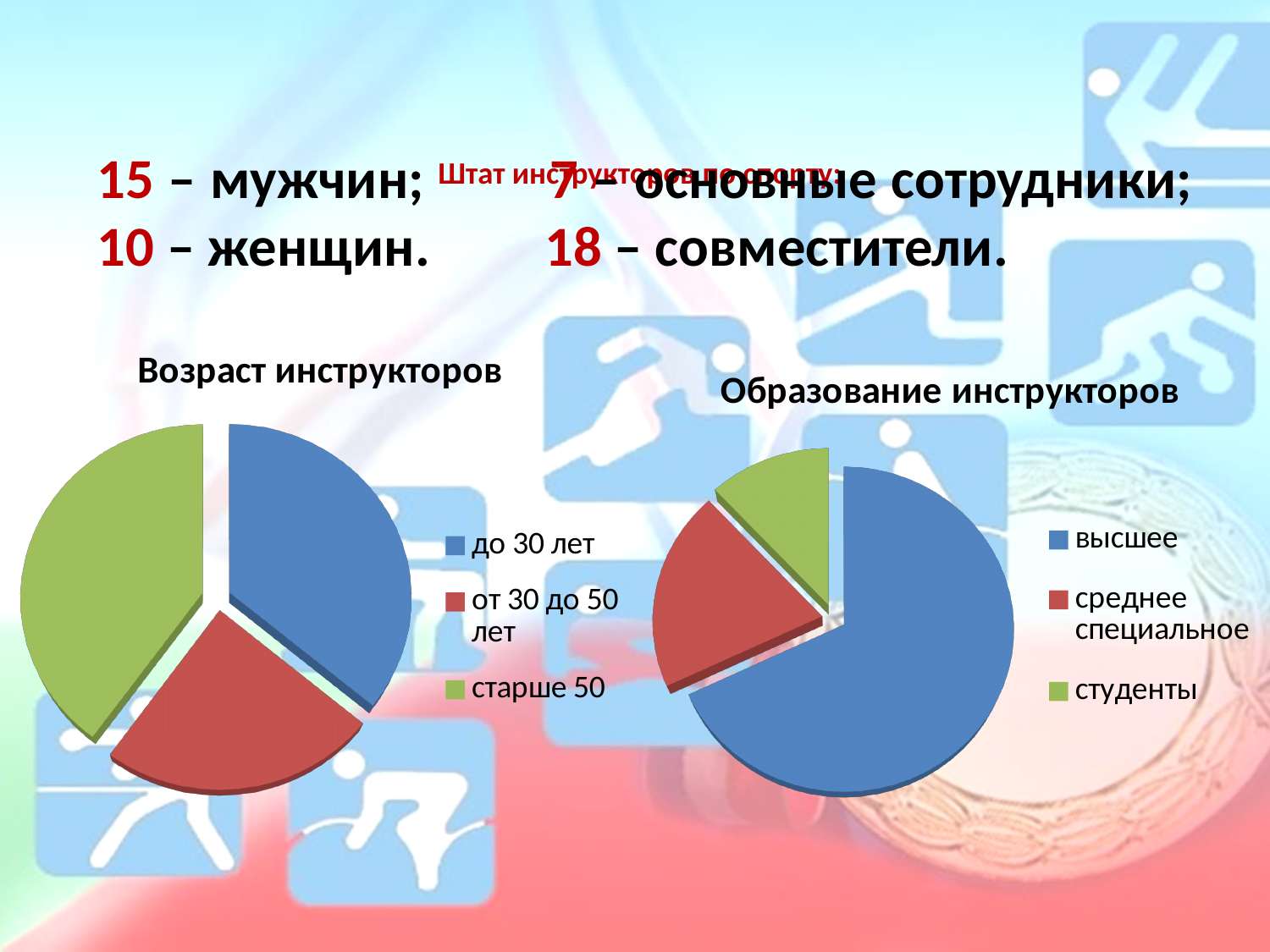
What kind of chart is the "Образование инструкторов" chart? pie chart What kind of chart is the "Возраст инструкторов" chart? pie chart In the "Возраст инструкторов" chart, what colour is the "старше 50" slice? green In the "Образование инструкторов" chart, how many categories does the legend list? 3 In the "Возраст инструкторов" chart, how many slices does the pie have? 3 In the "Образование инструкторов" chart, what colour is the "высшее" slice? blue In the "Образование инструкторов" chart, which category has the largest slice? высшее In the "Образование инструкторов" chart, which slice is larger: "среднее специальное" or "студенты"? среднее специальное In the "Образование инструкторов" chart, which slice is larger: "высшее" or "среднее специальное"? высшее In the "Образование инструкторов" chart, which category has the smallest slice? студенты In the "Возраст инструкторов" chart, how many categories does the legend list? 3